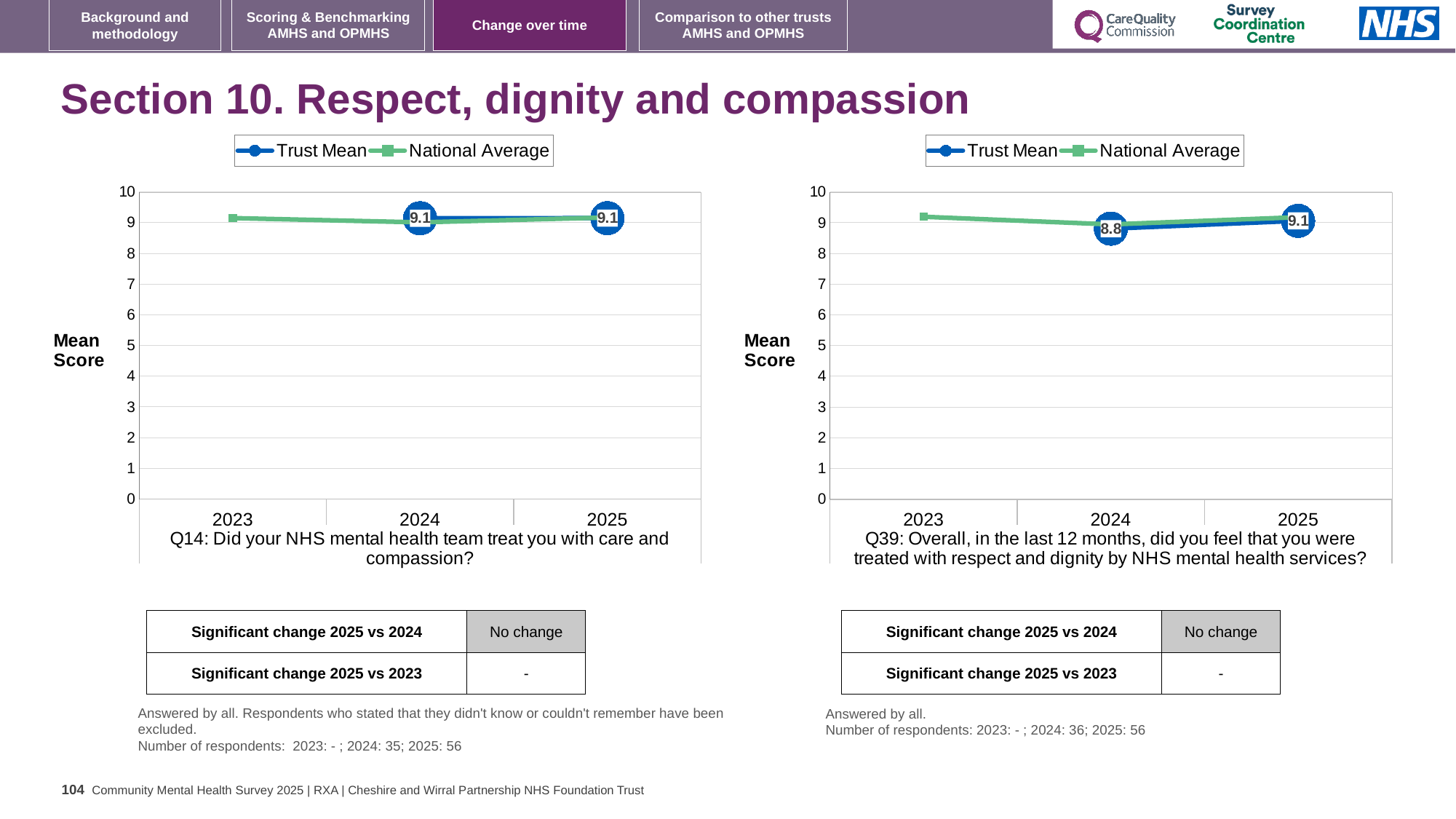
On the Q14 chart (left), what is the Trust Mean for 2024? 9.1 What kind of chart is the Q14 chart (left)? line chart On the Q39 chart (right), what is the Trust Mean for 2024? 8.8 On the Q39 chart (right), which year has the higher Trust Mean, 2024 or 2025? 2025 How many series does the legend of the Q14 chart (left) list? 2 On the Q39 chart (right), is the National Average for 2023 greater or less than 5? greater On the Q39 chart (right), does the Trust Mean rise or fall from 2024 to 2025? rise How many years are shown on the x axis of the Q39 chart (right)? 3 On the Q14 chart (left), is the National Average for 2023 greater or less than 8? greater On the Q39 chart (right), what is the difference between the Trust Mean for 2025 and 2024? 0.3 On the Q39 chart (right), what is the Trust Mean for 2025? 9.1 On the Q14 chart (left), what is the Trust Mean for 2025? 9.1